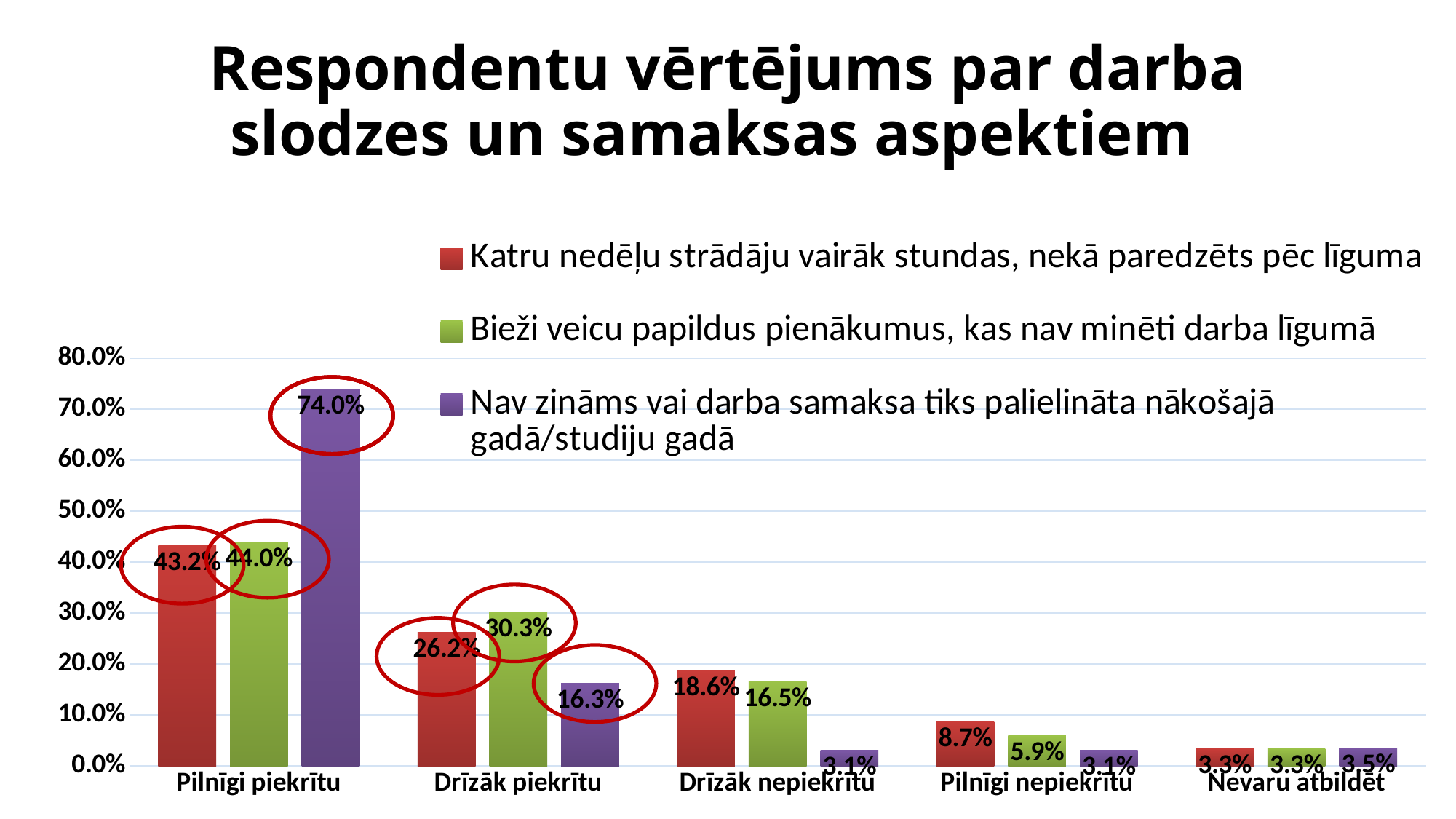
What type of chart is shown on the slide? bar chart Which colour represents the series 'Bieži veicu papildus pienākumus, kas nav minēti darba līgumā'? green How many categories are shown on the x axis? 5 In the 'Drīzāk nepiekrītu' category, which is larger: the value for 'Katru nedēļu strādāju vairāk stundas, nekā paredzēts pēc līguma' or for 'Bieži veicu papildus pienākumus, kas nav minēti darba līgumā'? Katru nedēļu strādāju vairāk stundas, nekā paredzēts pēc līguma Is the value for 'Nav zināms vai darba samaksa tiks palielināta nākošajā gadā/studiju gadā' in the 'Pilnīgi piekrītu' category greater or less than 70.0%? greater What is the value for 'Bieži veicu papildus pienākumus, kas nav minēti darba līgumā' in the 'Pilnīgi nepiekrītu' category? 5.9% What is the value for 'Nav zināms vai darba samaksa tiks palielināta nākošajā gadā/studiju gadā' in the 'Pilnīgi piekrītu' category? 74.0% Which category has the lowest value for 'Katru nedēļu strādāju vairāk stundas, nekā paredzēts pēc līguma'? Nevaru atbildēt How many series does the legend list? 3 Which category has the highest value for 'Nav zināms vai darba samaksa tiks palielināta nākošajā gadā/studiju gadā'? Pilnīgi piekrītu What is the difference between the 'Bieži veicu papildus pienākumus, kas nav minēti darba līgumā' value and the 'Katru nedēļu strādāju vairāk stundas, nekā paredzēts pēc līguma' value in the 'Drīzāk piekrītu' category? 4.1% What is the value for 'Katru nedēļu strādāju vairāk stundas, nekā paredzēts pēc līguma' in the 'Drīzāk piekrītu' category? 26.2%